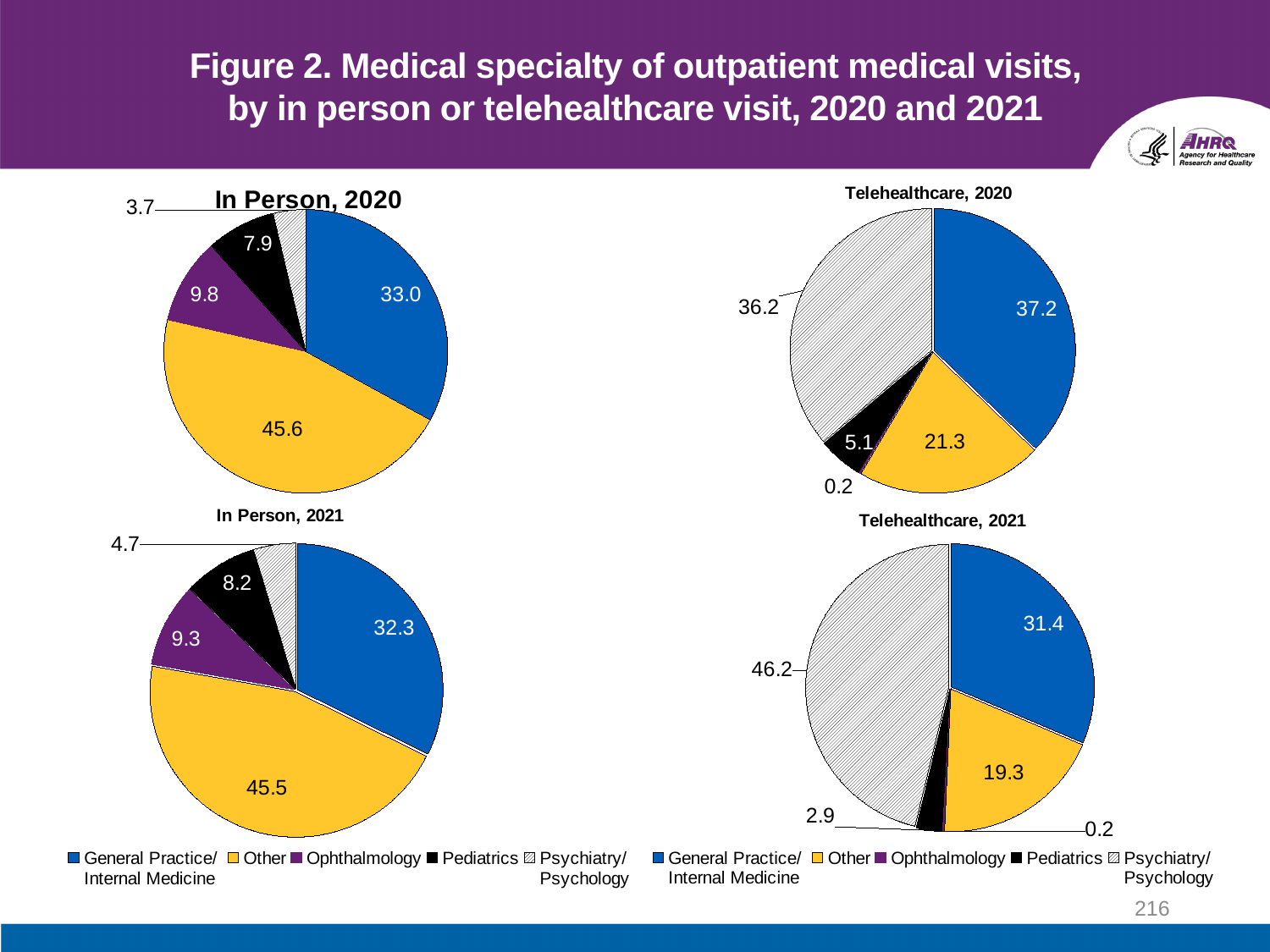
In the In Person, 2020 pie chart, what is the difference between the Other value and the General Practice/Internal Medicine value? 12.6 In the Telehealthcare, 2021 pie chart, what is the difference between the Psychiatry/Psychology value and the Other value? 26.9 What kind of chart is used for Telehealthcare, 2020? Pie chart In the In Person, 2020 pie chart, what is the value for Other? 45.6 In the In Person, 2021 pie chart, what is the value for Pediatrics? 8.2 In the In Person, 2020 pie chart, which category has the smallest share? Psychiatry/Psychology In the Telehealthcare, 2020 pie chart, which category has the smallest share? Ophthalmology In the Telehealthcare, 2021 pie chart, what is the value for General Practice/Internal Medicine? 31.4 How many categories does the legend list for the In Person, 2020 pie chart? 5 In the Telehealthcare, 2020 pie chart, what is the value for Psychiatry/Psychology? 36.2 In the Telehealthcare, 2021 pie chart, which category has the largest share? Psychiatry/Psychology In the In Person, 2021 pie chart, which is larger, Ophthalmology or Pediatrics? Ophthalmology